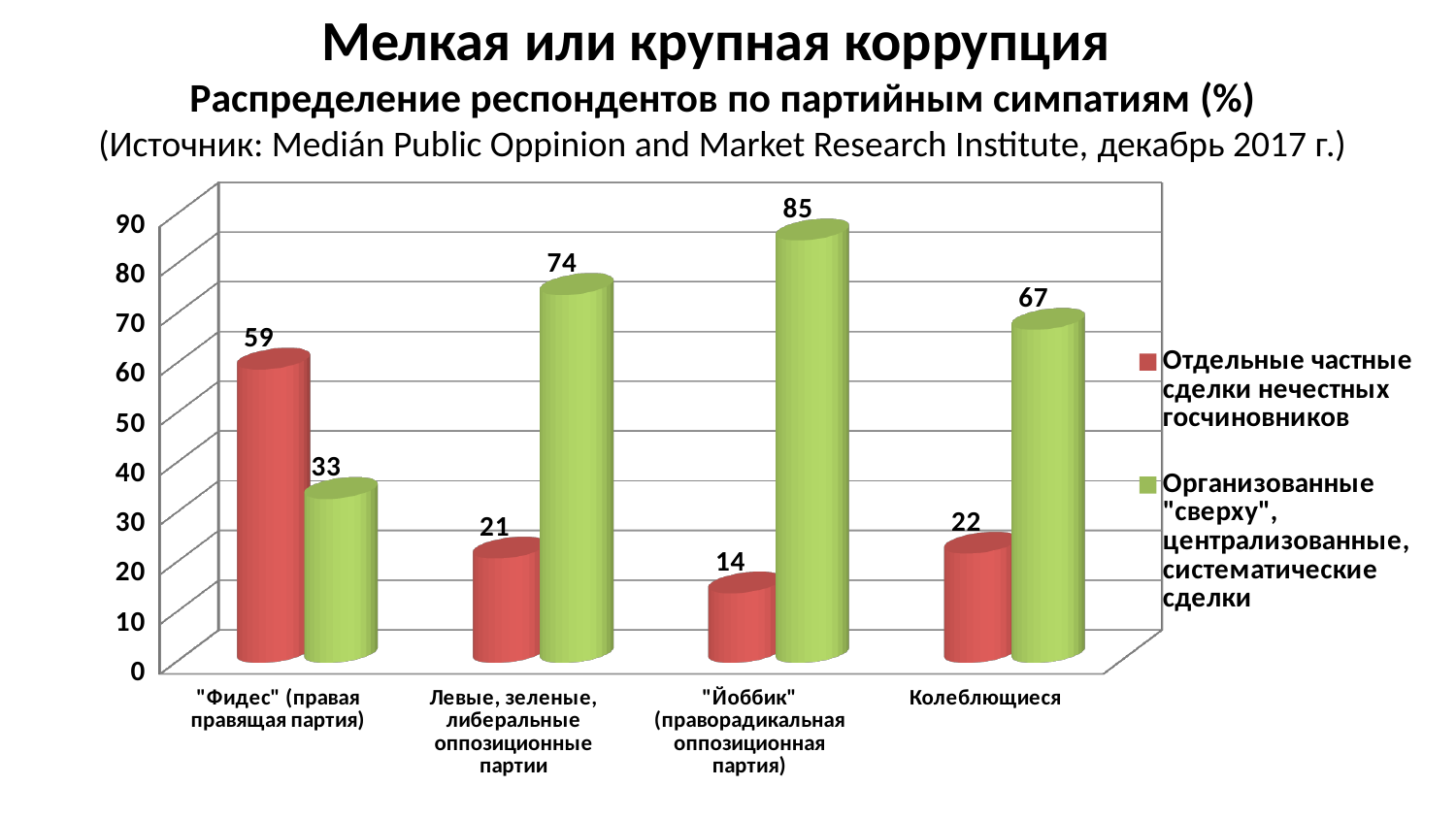
What is the value for "Йоббик" in the series "Организованные "сверху", централизованные, систематические сделки"? 85 Is the value for "Колеблющиеся" in the green series greater or less than 60? greater How many categories are shown on the x axis? 4 Which category has the lowest value in the series "Отдельные частные сделки нечестных госчиновников"? "Йоббик" (праворадикальная оппозиционная партия) What kind of chart is shown on the slide? Bar chart For "Левые, зеленые, либеральные оппозиционные партии", which series has the larger value? Организованные "сверху", централизованные, систематические сделки What is the difference between the two series values for "Фидес"? 26 What is the value for "Фидес" in the series "Отдельные частные сделки нечестных госчиновников"? 59 What is the value for "Колеблющиеся" in the series "Отдельные частные сделки нечестных госчиновников"? 22 What colour represents the series "Отдельные частные сделки нечестных госчиновников"? Red Which category has the highest value in the series "Организованные "сверху", централизованные, систематические сделки"? "Йоббик" (праворадикальная оппозиционная партия) How many series does the legend list? 2